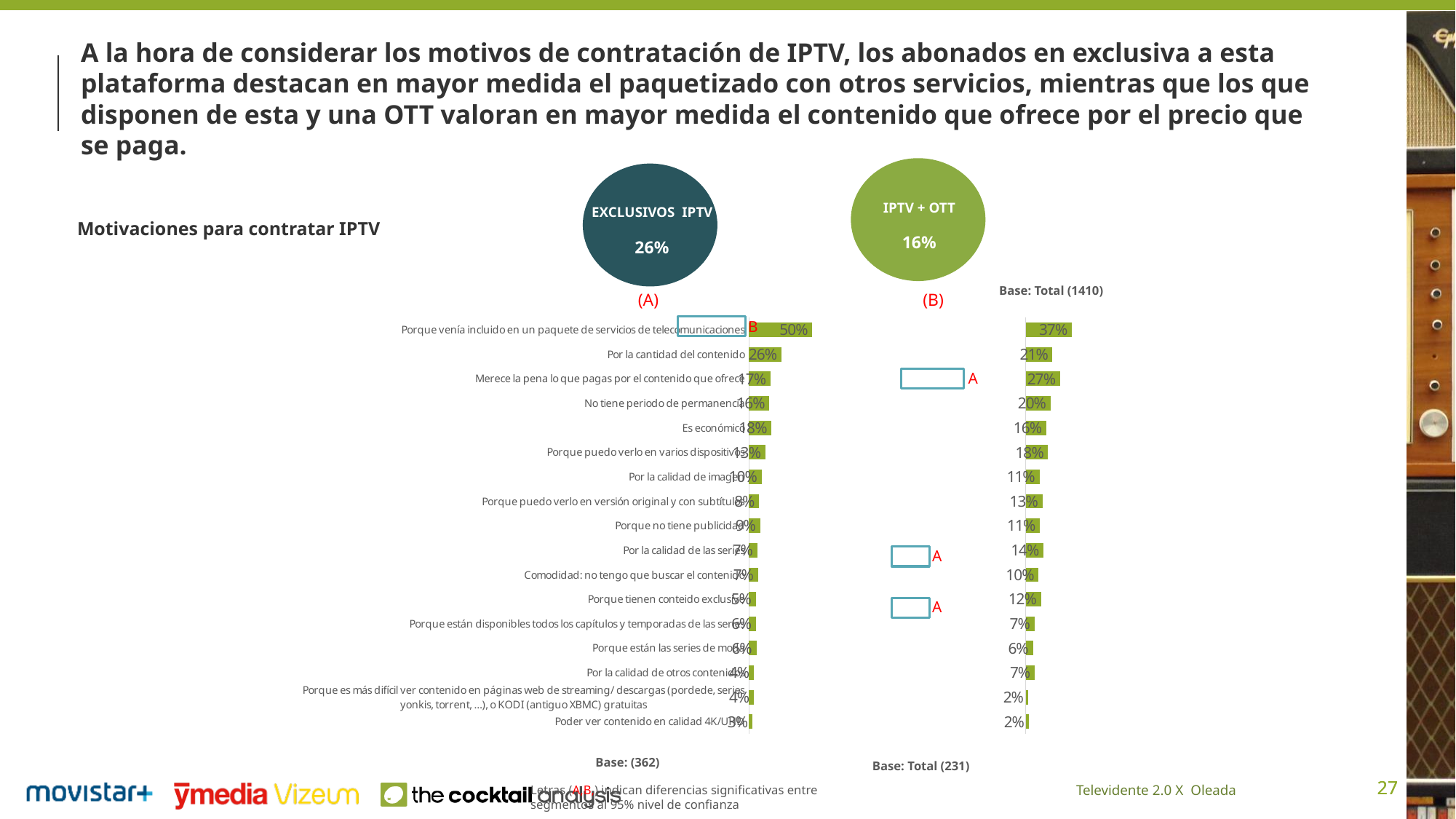
In the IPTV + OTT chart, what percentage is shown for 'Porque venía incluido en un paquete de servicios de telecomunicaciones'? 37% For 'Merece la pena lo que pagas por el contenido que ofrece', which group has the larger value, EXCLUSIVOS IPTV or IPTV + OTT? IPTV + OTT In the IPTV + OTT chart, which motivation has the highest percentage? Porque venía incluido en un paquete de servicios de telecomunicaciones In the EXCLUSIVOS IPTV chart, what percentage is shown for 'Por la cantidad del contenido'? 26% In the EXCLUSIVOS IPTV chart, which motivation has the highest percentage? Porque venía incluido en un paquete de servicios de telecomunicaciones What is the difference in percentage points between the EXCLUSIVOS IPTV and IPTV + OTT values for 'Porque venía incluido en un paquete de servicios de telecomunicaciones'? 13 percentage points In the EXCLUSIVOS IPTV chart, what percentage is shown for 'Porque venía incluido en un paquete de servicios de telecomunicaciones'? 50% In the IPTV + OTT chart, what percentage is shown for 'Merece la pena lo que pagas por el contenido que ofrece'? 27% What percentage is shown inside the EXCLUSIVOS IPTV circle above the chart? 26% In the IPTV + OTT chart, what percentage is shown for 'Por la cantidad del contenido'? 21% What type of chart is used to show the motivations for contracting IPTV? Bar chart How many motivation categories are listed in the charts? 17